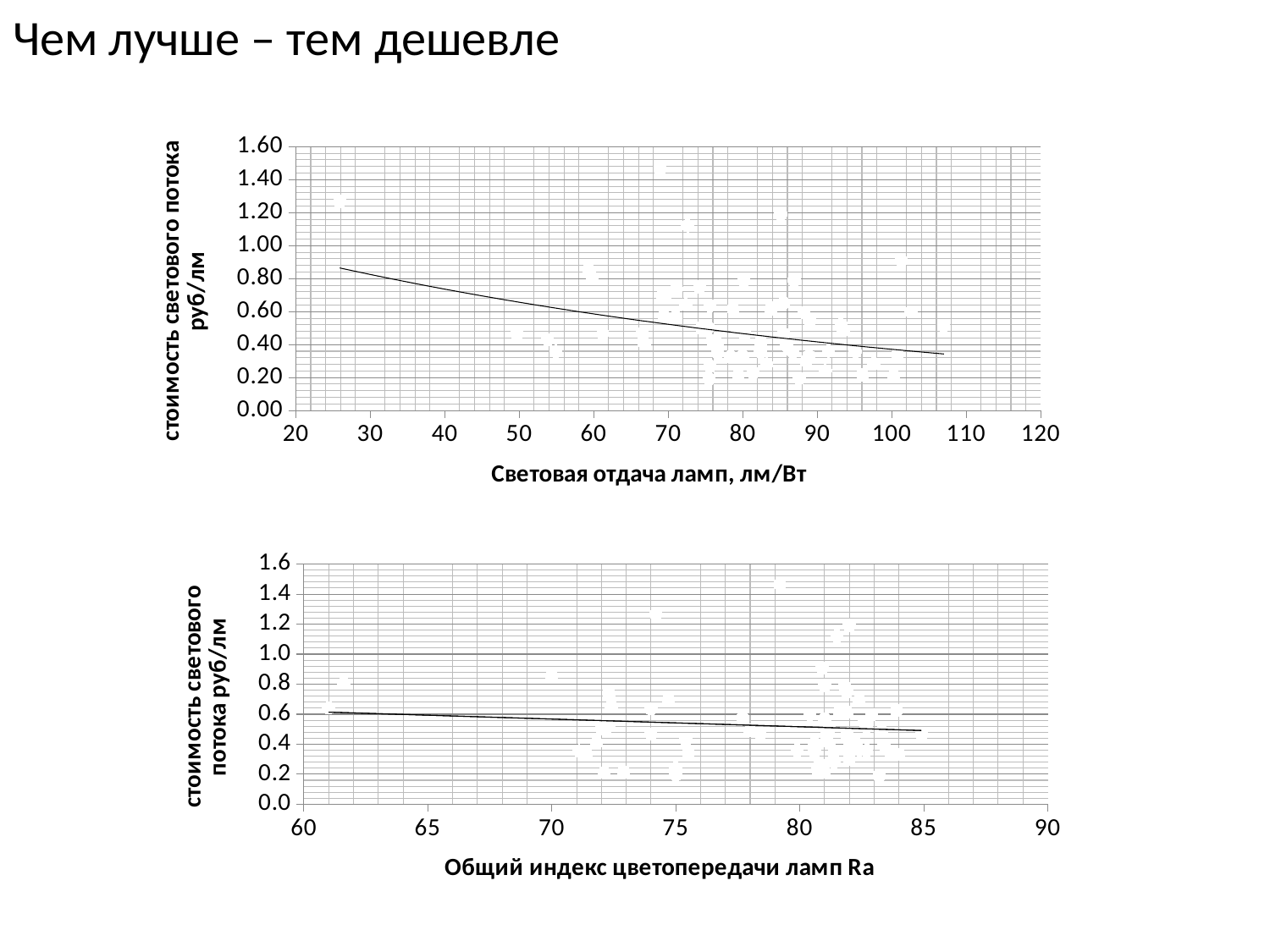
What is the maximum value shown on the x axis of the top chart? 120 In the bottom chart, is the trend line value at Ra 80 greater or less than 0.2? greater In the bottom chart, is the trend line value at Ra 70 greater or less than 1.0? less In the bottom chart, does the trend line rise or fall as the colour rendering index Ra increases? fall In the top chart, is the trend line value at a luminous efficacy of 60 лм/Вт greater or less than 0.80? less What is the x-axis title of the top chart? Световая отдача ламп, лм/Вт What kind of chart is the top chart on the slide? scatter chart What is the x-axis title of the bottom chart? Общий индекс цветопередачи ламп Ra In the top chart, does the trend line rise or fall as luminous efficacy (Световая отдача ламп) increases? fall What kind of chart is the bottom chart on the slide? scatter chart How many charts are shown on the slide? 2